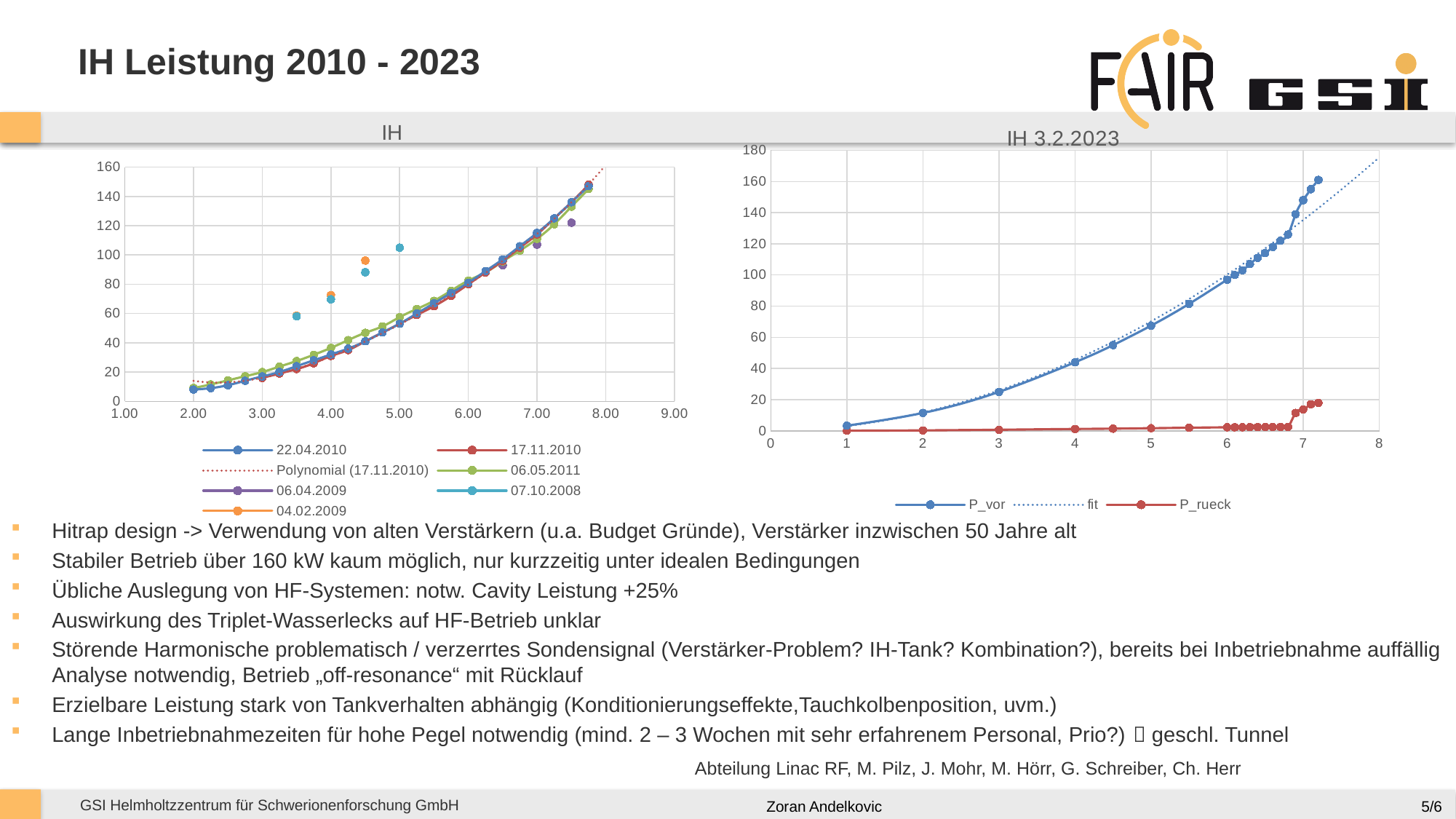
In the right chart "IH 3.2.2023", does the P_vor series rise or fall as the x value increases? rise What kind of chart is the left chart titled "IH"? line chart What kind of chart is the right chart titled "IH 3.2.2023"? line chart How many series does the legend of the left chart "IH" list? 7 How many series does the legend of the right chart "IH 3.2.2023" list? 3 In the right chart "IH 3.2.2023", which series is drawn as a dotted line? fit In the right chart "IH 3.2.2023", is the P_rueck value at x = 5 greater or less than 20? less In the left chart "IH", is the value of the 04.02.2009 series at x = 4.50 greater or less than 80? greater In the right chart "IH 3.2.2023", is the P_vor value at x = 5 greater or less than 60? greater In the right chart "IH 3.2.2023", which series is larger at x = 6, P_vor or P_rueck? P_vor In the left chart "IH", which series has the larger value at x = 4.00, 04.02.2009 or 22.04.2010? 04.02.2009 In the right chart "IH 3.2.2023", which series reaches the highest value? P_vor